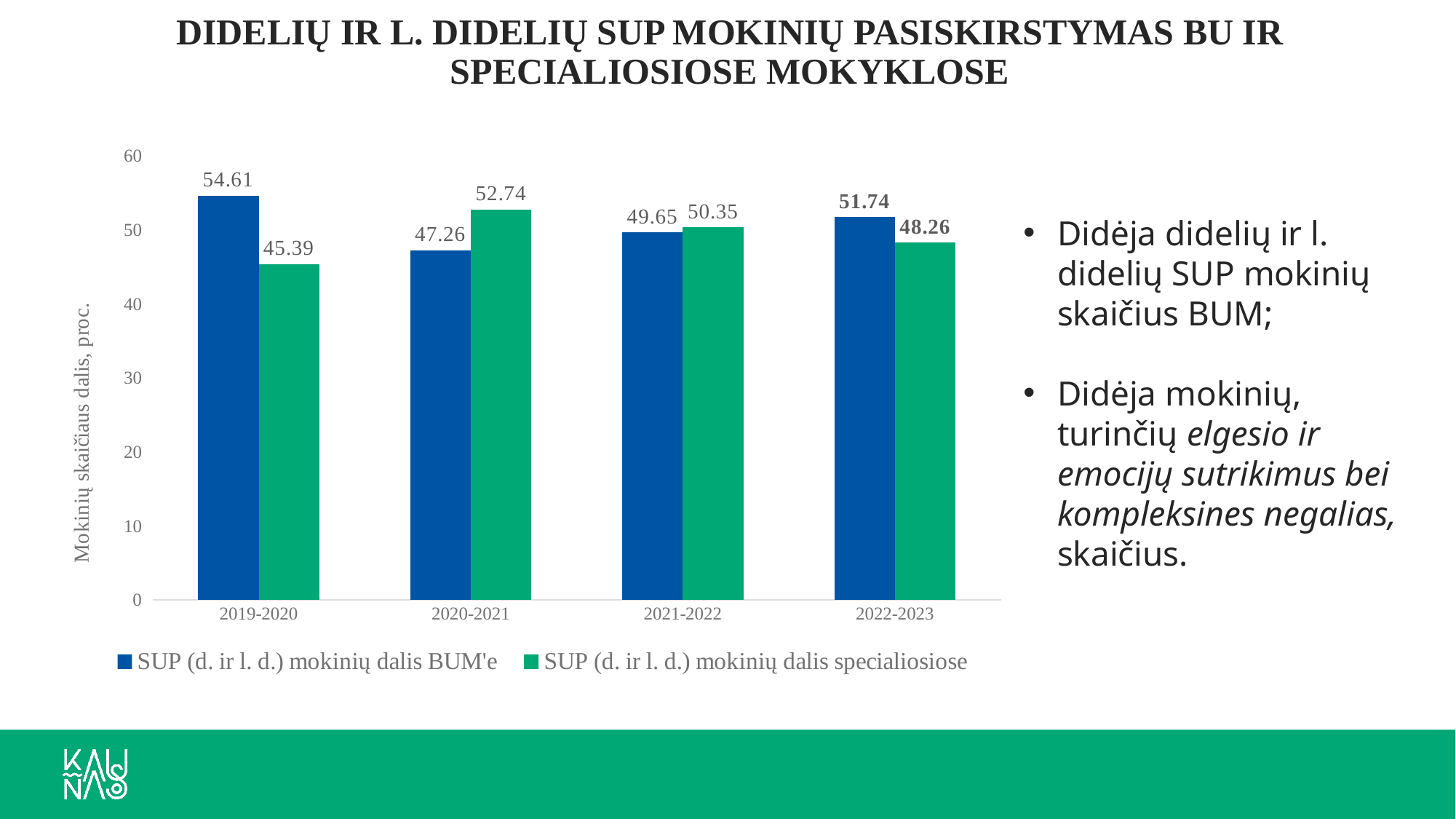
In which school year is the 'SUP (d. ir l. d.) mokinių dalis specialiosiose' value the lowest? 2019-2020 What is the difference between the BUM'e value and the specialiosiose value in 2019-2020? 9.22 How many school years are shown on the x axis? 4 What is the value for 'SUP (d. ir l. d.) mokinių dalis specialiosiose' in 2020-2021? 52.74 What is the value for 'SUP (d. ir l. d.) mokinių dalis BUM'e' in 2022-2023? 51.74 What is the value for 'SUP (d. ir l. d.) mokinių dalis specialiosiose' in 2021-2022? 50.35 What is the value for 'SUP (d. ir l. d.) mokinių dalis BUM'e' in 2019-2020? 54.61 How many series does the legend list? 2 In which school year is the 'SUP (d. ir l. d.) mokinių dalis BUM'e' value the highest? 2019-2020 What kind of chart is shown on the slide? Bar chart In 2020-2021, which series has the larger value: BUM'e or specialiosiose? SUP (d. ir l. d.) mokinių dalis specialiosiose What is the label of the vertical axis? Mokinių skaičiaus dalis, proc.